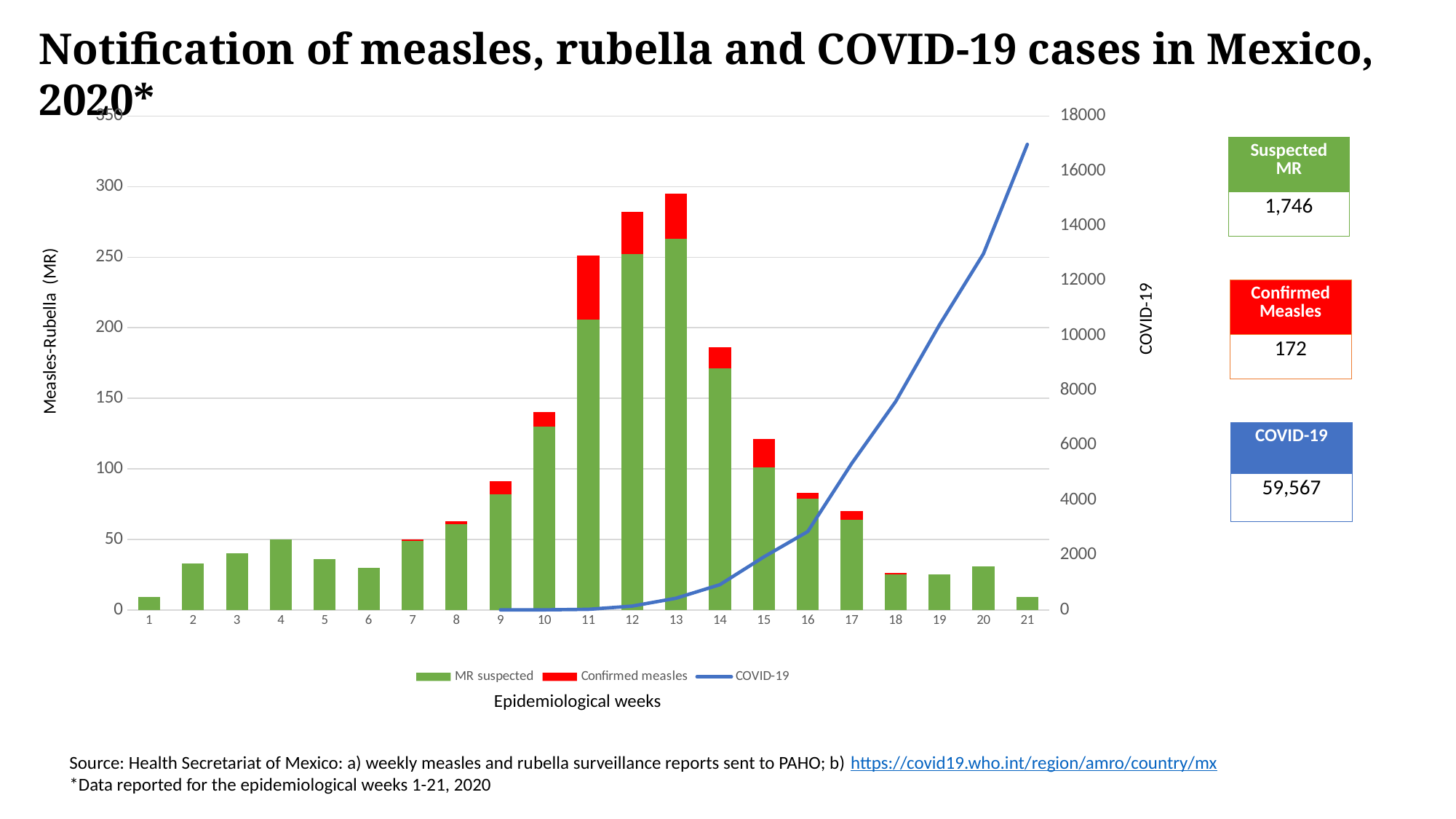
What total number of COVID-19 cases is shown in the box beside the chart? 59,567 What kind of chart is used to plot the MR suspected and Confirmed measles series? bar chart Is the total stacked bar value for week 2 greater or less than 50? less Is the total stacked bar value for week 12 greater or less than 250? greater Is the total stacked bar value for week 10 greater or less than 150? less Does the COVID-19 line rise or fall from week 9 to week 21? rise How many epidemiological weeks are shown on the x axis? 21 What total number of Suspected MR cases is shown in the box beside the chart? 1,746 Which epidemiological week has the tallest stacked bar (MR suspected plus Confirmed measles)? 13 How many series does the legend list? 3 Which has the taller stacked bar, week 12 or week 14? week 12